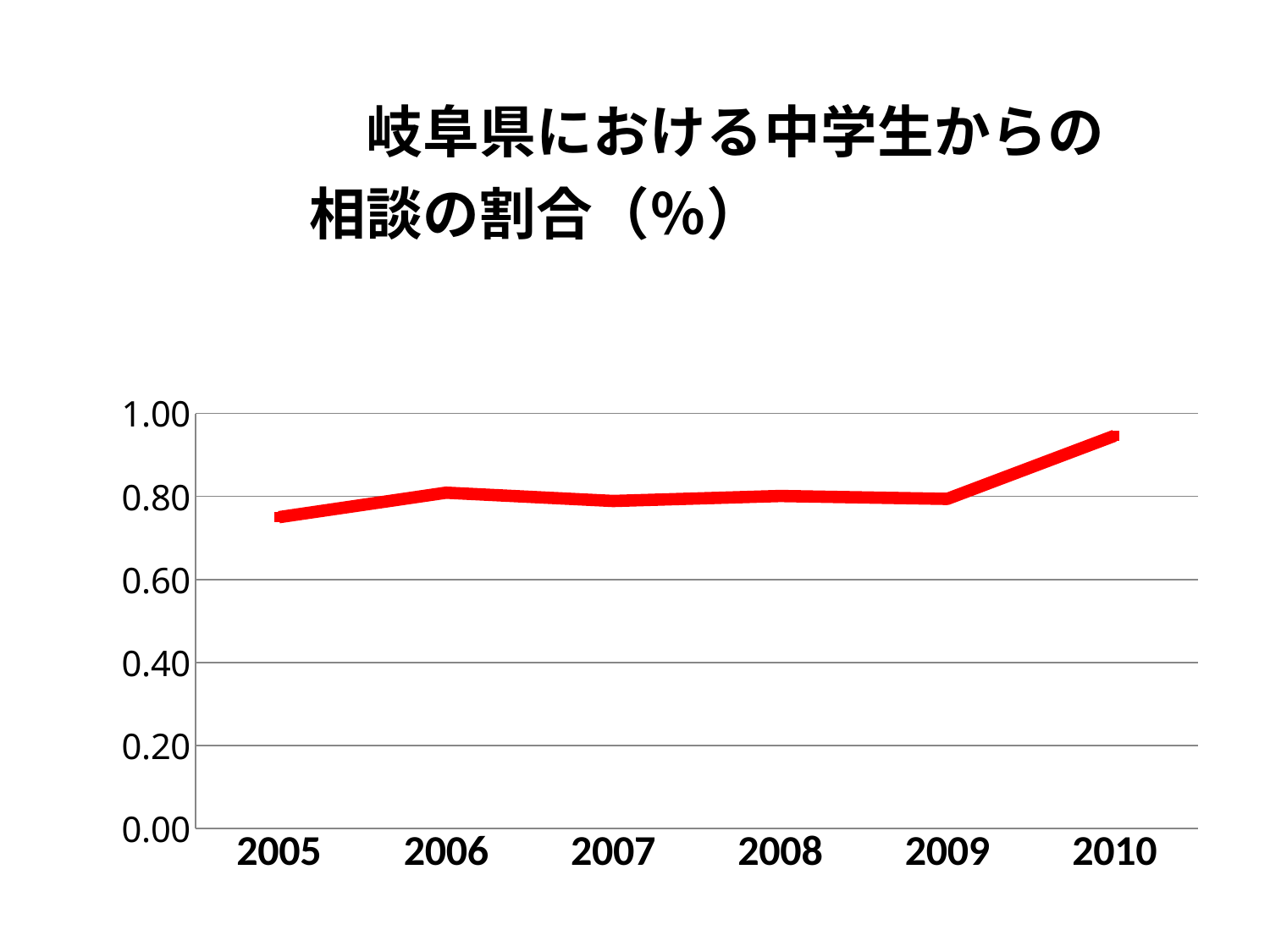
Does the value rise or fall from 2009 to 2010? rise Which year has the highest value? 2010 Is the value for 2008 greater or less than 0.60? greater What colour is the plotted line? red Which year has the lowest value? 2005 How many years are plotted on the x axis? 6 Is the value for 2005 greater or less than 0.80? less Is the value for 2010 greater or less than 1.00? less Which is larger, the value for 2005 or the value for 2006? 2006 Which is larger, the value for 2005 or the value for 2010? 2010 What kind of chart is shown on the slide? line chart